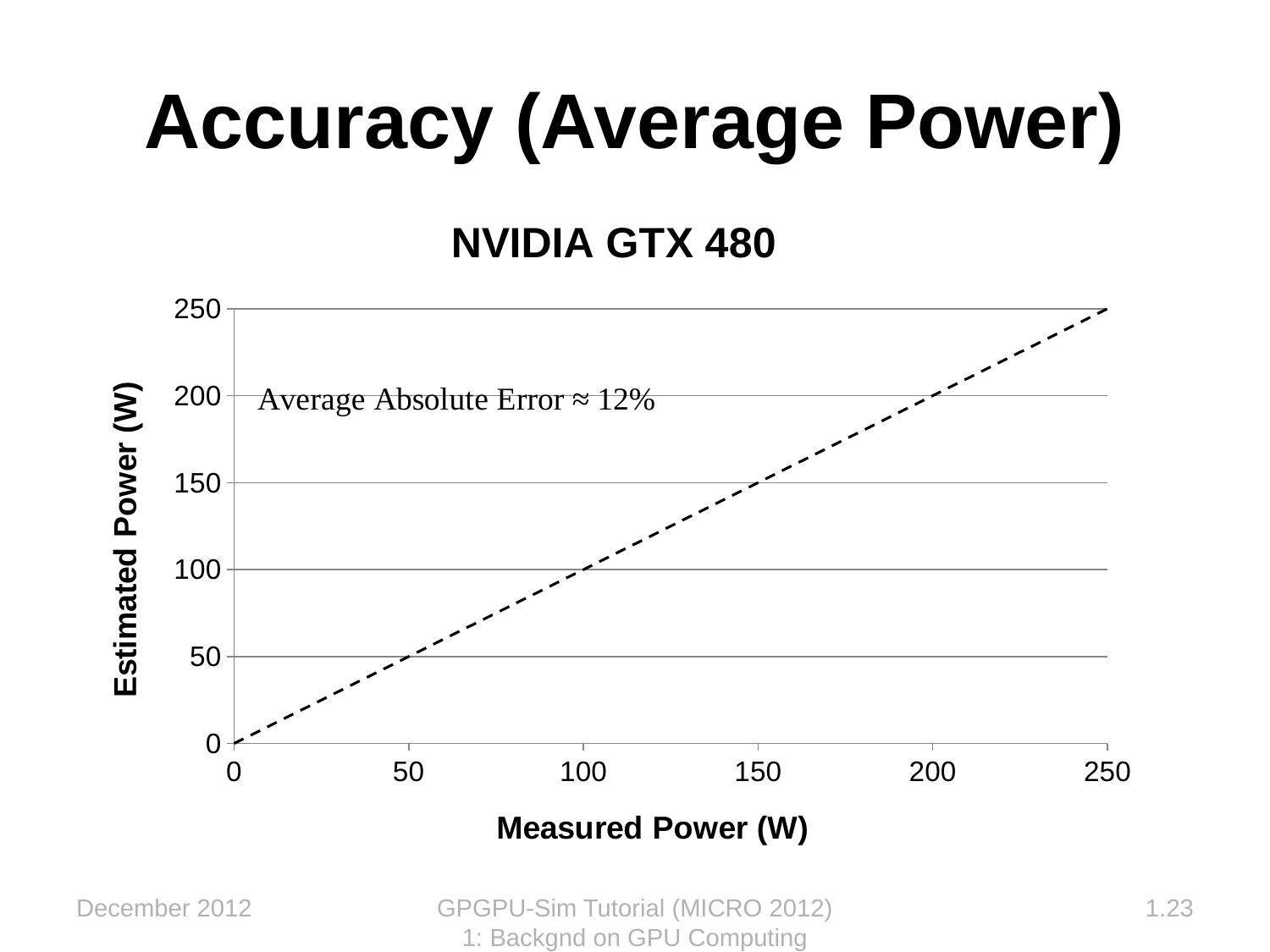
What is the title of the chart? NVIDIA GTX 480 What is the Estimated Power value of the dashed line where Measured Power is 250? 250 What is the Estimated Power value of the dashed line where Measured Power is 0? 0 Is the Estimated Power value of the dashed line at Measured Power 200 greater or less than 150? greater Is the Estimated Power value of the dashed line at Measured Power 50 greater or less than 100? less Does the dashed line rise or fall as Measured Power increases along the x axis? rise What is the highest value shown on the y axis (Estimated Power)? 250 What average absolute error is stated on the chart? ≈ 12% What is the Estimated Power value of the dashed line where Measured Power is 100? 100 What kind of chart is shown on the slide? line chart